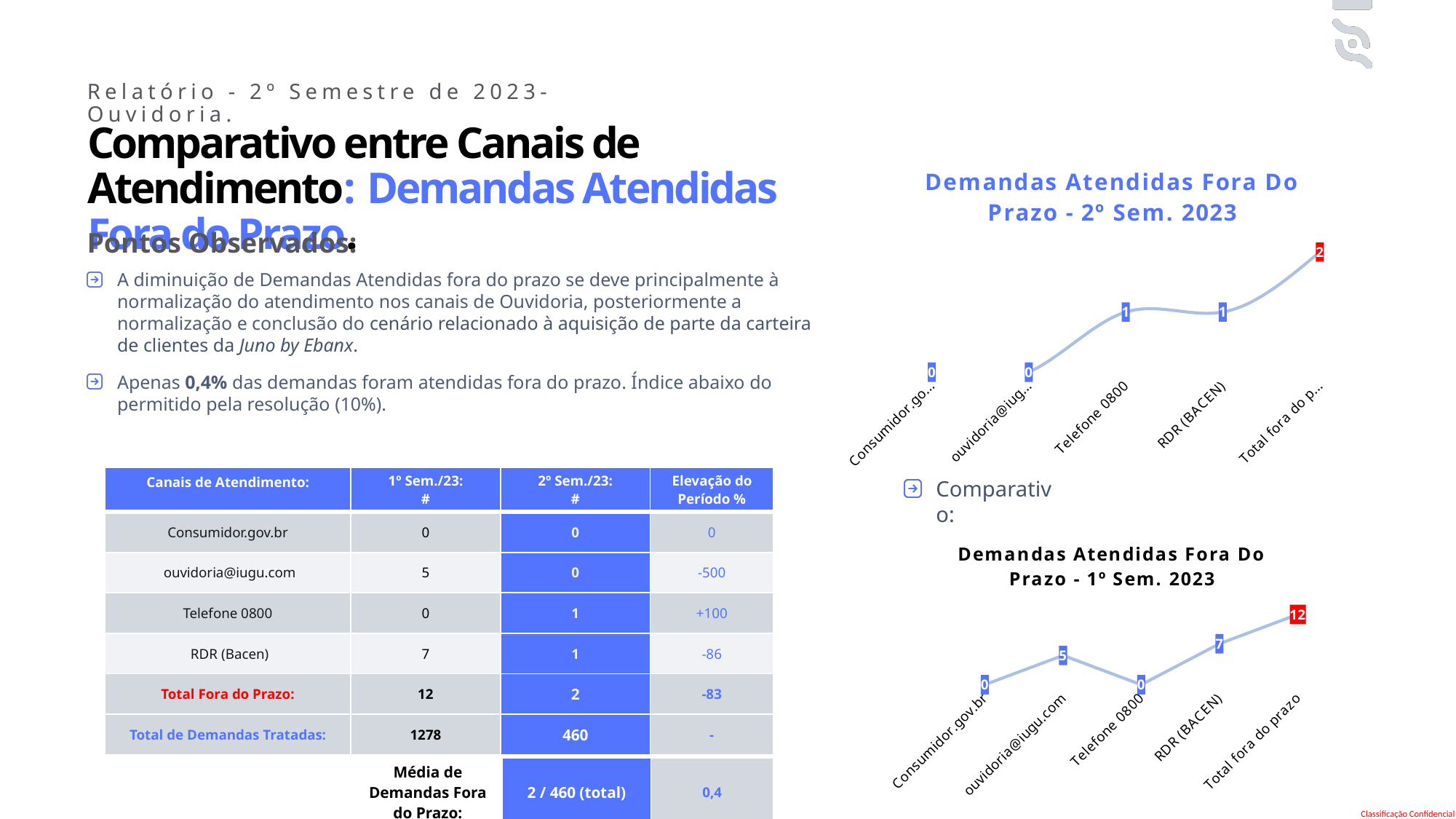
In the chart titled 'Demandas Atendidas Fora Do Prazo - 1º Sem. 2023', what is the value for Total fora do prazo? 12 What kind of chart is 'Demandas Atendidas Fora Do Prazo - 2º Sem. 2023'? Line chart In the chart titled 'Demandas Atendidas Fora Do Prazo - 2º Sem. 2023', how many data points are plotted? 5 In the chart titled 'Demandas Atendidas Fora Do Prazo - 1º Sem. 2023', which is larger: the value for ouvidoria@iugu.com or the value for Telefone 0800? ouvidoria@iugu.com In the chart titled 'Demandas Atendidas Fora Do Prazo - 1º Sem. 2023', what is the difference between the values for RDR (BACEN) and ouvidoria@iugu.com? 2 Which of the two charts has the higher value for RDR (BACEN): the 1º Sem. 2023 chart or the 2º Sem. 2023 chart? 1º Sem. 2023 In the chart titled 'Demandas Atendidas Fora Do Prazo - 1º Sem. 2023', which category has the highest value? Total fora do prazo In the chart titled 'Demandas Atendidas Fora Do Prazo - 1º Sem. 2023', what is the value for RDR (BACEN)? 7 In the chart titled 'Demandas Atendidas Fora Do Prazo - 2º Sem. 2023', what is the value for Telefone 0800? 1 In the chart titled 'Demandas Atendidas Fora Do Prazo - 1º Sem. 2023', what is the value for ouvidoria@iugu.com? 5 In the chart titled 'Demandas Atendidas Fora Do Prazo - 2º Sem. 2023', what is the highest value shown? 2 In the chart titled 'Demandas Atendidas Fora Do Prazo - 2º Sem. 2023', what is the value for RDR (BACEN)? 1